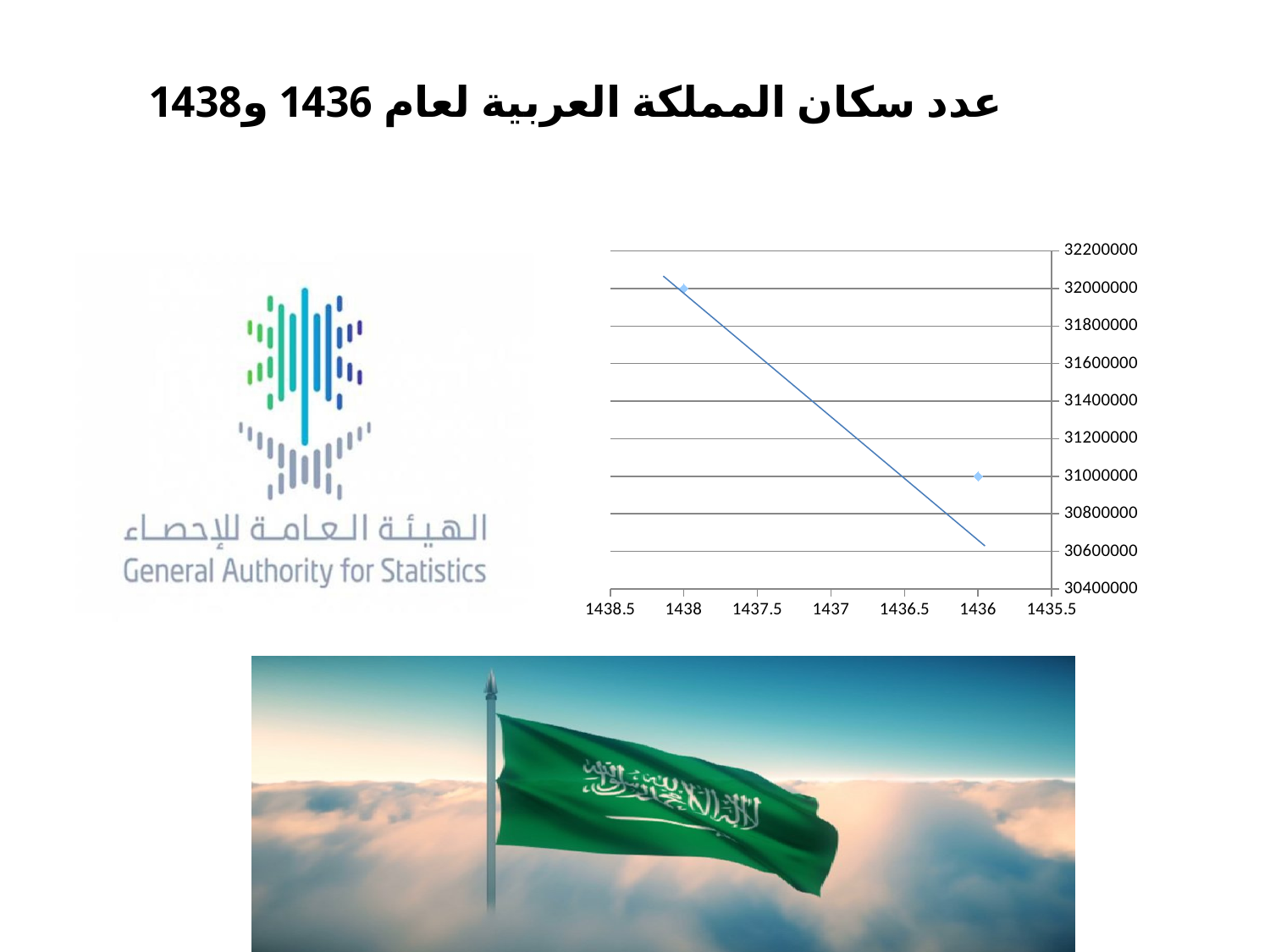
Is the value for 1436 greater or less than 31400000? less How many data points are plotted on the chart? 2 What kind of chart is shown on the slide? scatter chart Which year has the lower population value on the chart, 1436 or 1438? 1436 Do the plotted values rise or fall moving from left to right along the x axis? fall Is the value for 1438 larger or smaller than the value for 1436? larger Is the value for 1436 greater or less than 30800000? greater Is the value for 1438 greater or less than 32200000? less What is the highest value labelled on the y axis of the chart? 32200000 Which year has the higher population value on the chart, 1436 or 1438? 1438 What is the leftmost label on the x axis of the chart? 1438.5